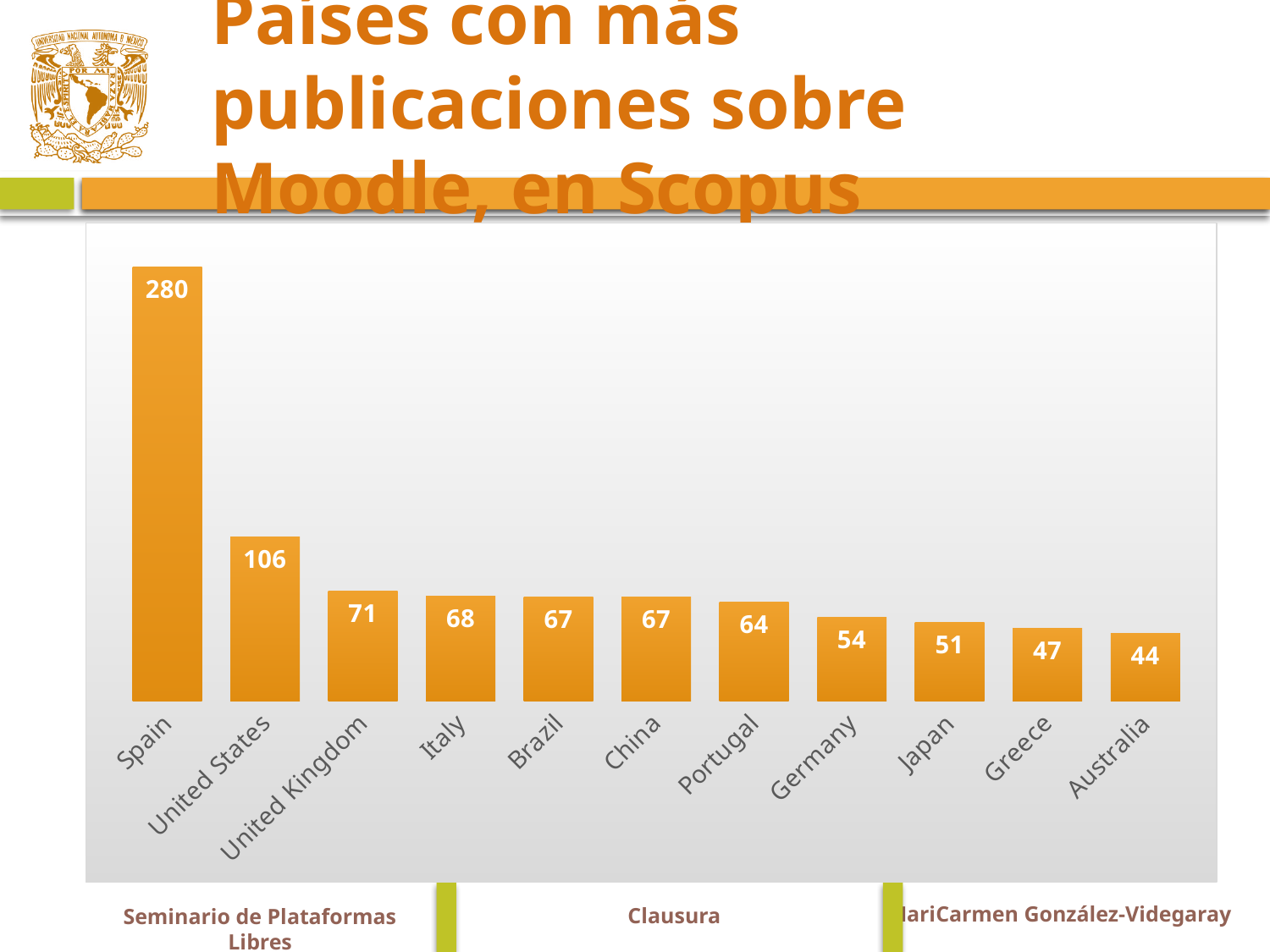
Do the values rise or fall from left to right along the x axis? Fall What is the difference between the values for Spain and United States? 174 Which country has the lowest value? Australia How many countries are shown in the chart? 11 What is the value for Portugal? 64 Which country has the highest value? Spain What is the difference between the values for United Kingdom and Italy? 3 What is the value for United States? 106 What is the value for Spain? 280 What kind of chart is shown on the slide? Bar chart What is the value for Australia? 44 Which has a larger value, Germany or Japan? Germany